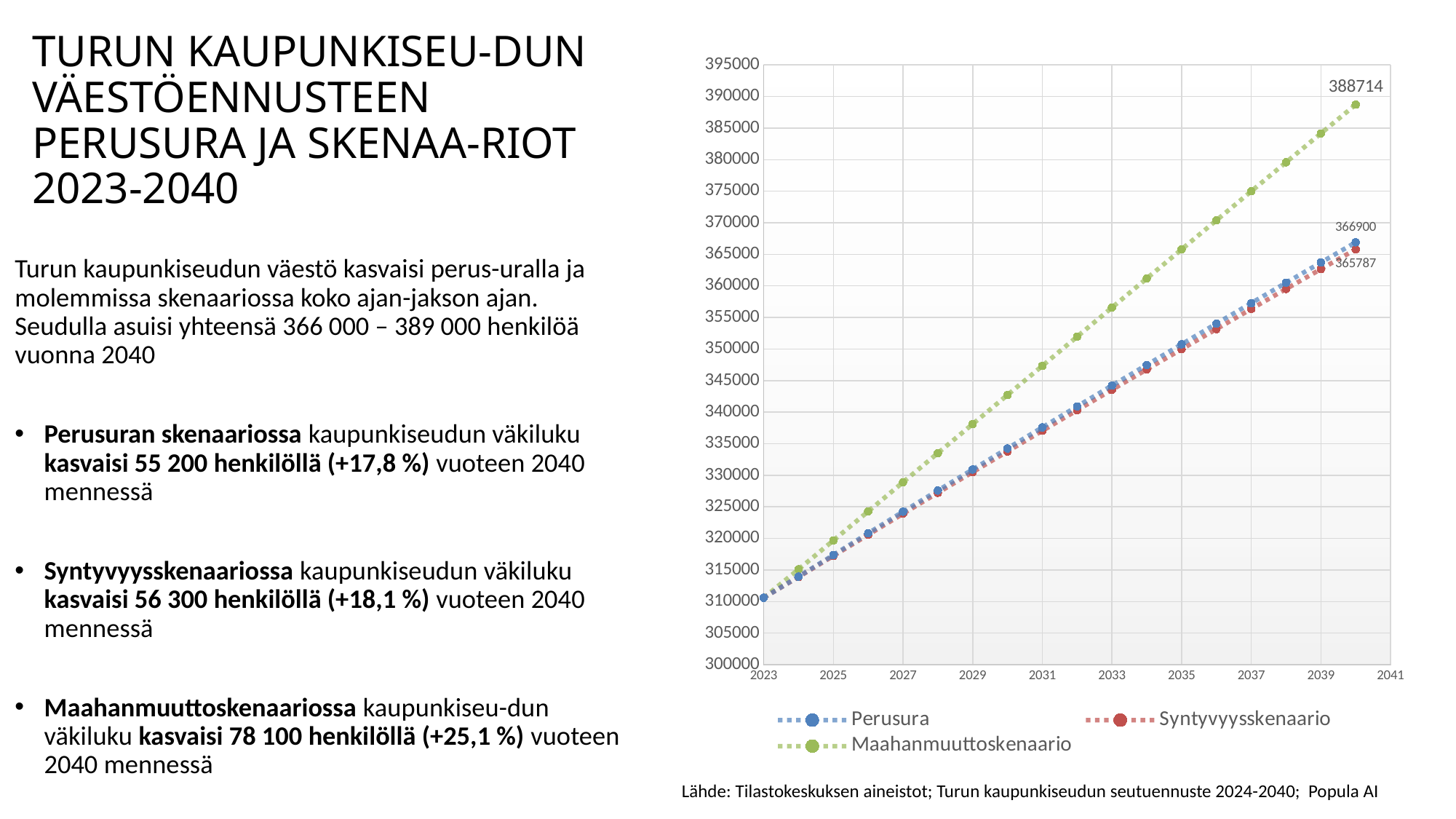
Is the value for Perusura in 2029 greater or less than 335000? less What is the difference between the 2040 values of Maahanmuuttoskenaario and Perusura? 21814 Is the value for Maahanmuuttoskenaario in 2035 greater or less than 360000? greater Which series has the highest value in 2040? Maahanmuuttoskenaario What is the difference between the 2040 values of Perusura and Syntyvyysskenaario? 1113 Which series has the lowest value in 2040? Syntyvyysskenaario What kind of chart is shown on the slide? Line chart How many series does the legend list? 3 In 2040, which is larger: the Perusura value or the Syntyvyysskenaario value? Perusura What is the labelled value of the Syntyvyysskenaario series in 2040? 365787 What is the labelled value of the Maahanmuuttoskenaario series in 2040? 388714 What is the labelled value of the Perusura series in 2040? 366900